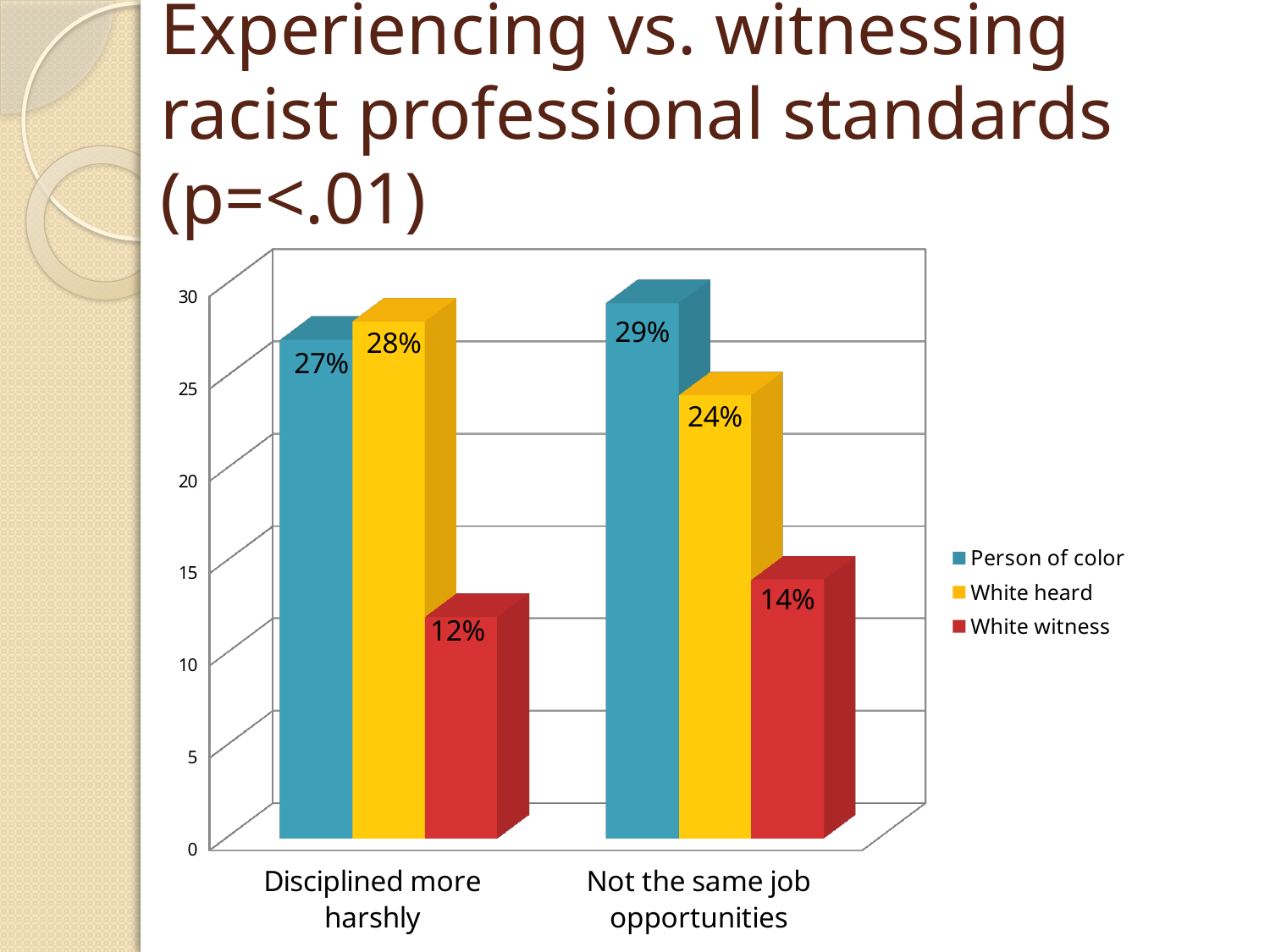
What colour represents the White witness series? Red Which is larger: the White heard value for Disciplined more harshly or the White heard value for Not the same job opportunities? Disciplined more harshly What kind of chart is shown on the slide? Bar chart What is the difference between the White heard values for Disciplined more harshly and Not the same job opportunities? 4% Which series has the highest value in the Not the same job opportunities category? Person of color How many categories are shown on the x axis? 2 What is the value for Person of color in the Disciplined more harshly category? 27% How many series does the legend list? 3 What is the value for White witness in the Disciplined more harshly category? 12% Which series has the lowest value in the Disciplined more harshly category? White witness What is the value for White heard in the Not the same job opportunities category? 24% What is the difference between the Person of color and White witness values in the Not the same job opportunities category? 15%